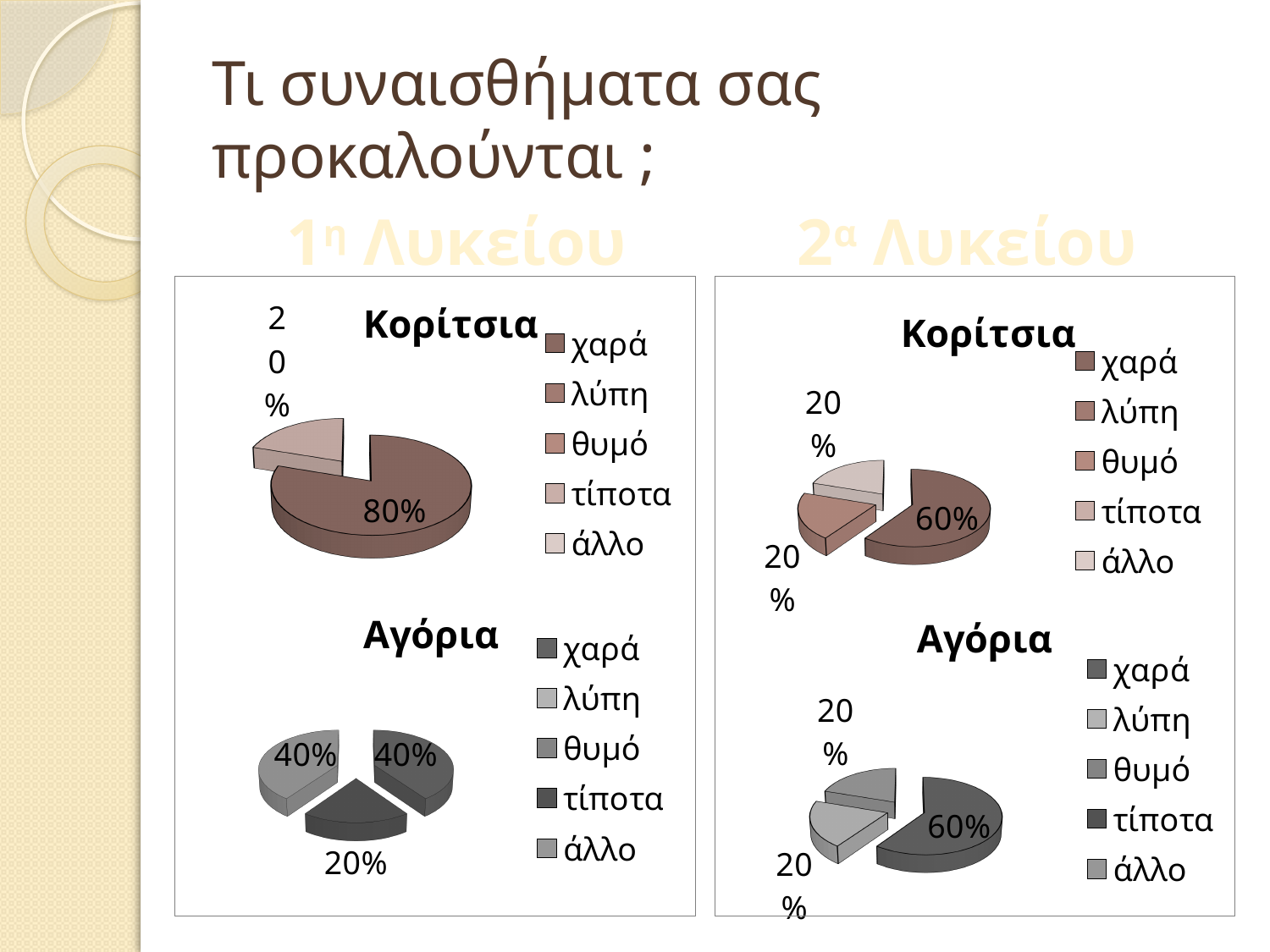
What type of chart is used for the Κορίτσια and Αγόρια data on this slide? Pie chart In the 1η Λυκείου Αγόρια pie chart, what percentage is shown for the bottom (τίποτα) slice? 20% In the 1η Λυκείου Κορίτσια pie chart, what is the difference between the 80% slice and the 20% slice? 60% How many slices does the 2α Λυκείου Κορίτσια pie chart have? 3 Which is larger: the χαρά share in the 1η Λυκείου Κορίτσια chart or the χαρά share in the 2α Λυκείου Κορίτσια chart? 1η Λυκείου Κορίτσια In the 1η Λυκείου Κορίτσια pie chart, what percentage is shown for the largest slice (χαρά)? 80% In the 2α Λυκείου Κορίτσια pie chart, what percentage is shown for χαρά? 60% How many entries does the legend of the 1η Λυκείου Αγόρια chart list? 5 How many slices does the 1η Λυκείου Κορίτσια pie chart have? 2 In the 2α Λυκείου Αγόρια pie chart, what percentage is shown for χαρά? 60% What is the title of the top chart in the 2α Λυκείου panel? Κορίτσια In the 1η Λυκείου Κορίτσια pie chart, what percentage is shown for the smaller slice? 20%